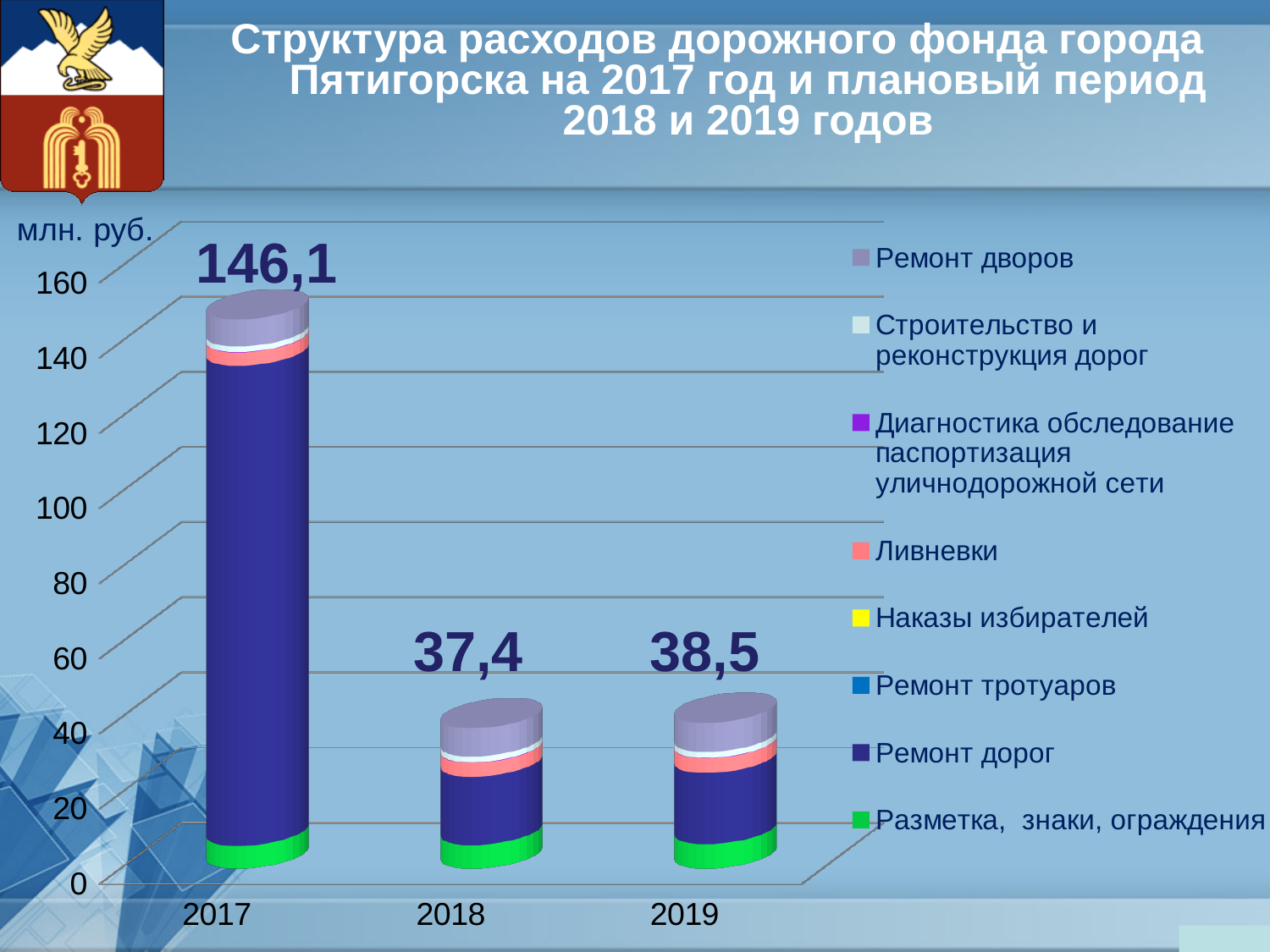
What unit of measurement is indicated on the chart? млн. руб. Which year has the lowest total? 2018 How many series does the legend list? 8 What is the total value shown for 2017? 146,1 What is the difference between the totals for 2019 and 2018? 1,1 What is the total value shown for 2019? 38,5 Is the total for 2017 greater or less than 140? greater What is the total value shown for 2018? 37,4 Which year has the highest total? 2017 How many years are shown on the x axis? 3 What is the difference between the totals for 2017 and 2018? 108,7 What kind of chart is shown on the slide? Stacked bar chart